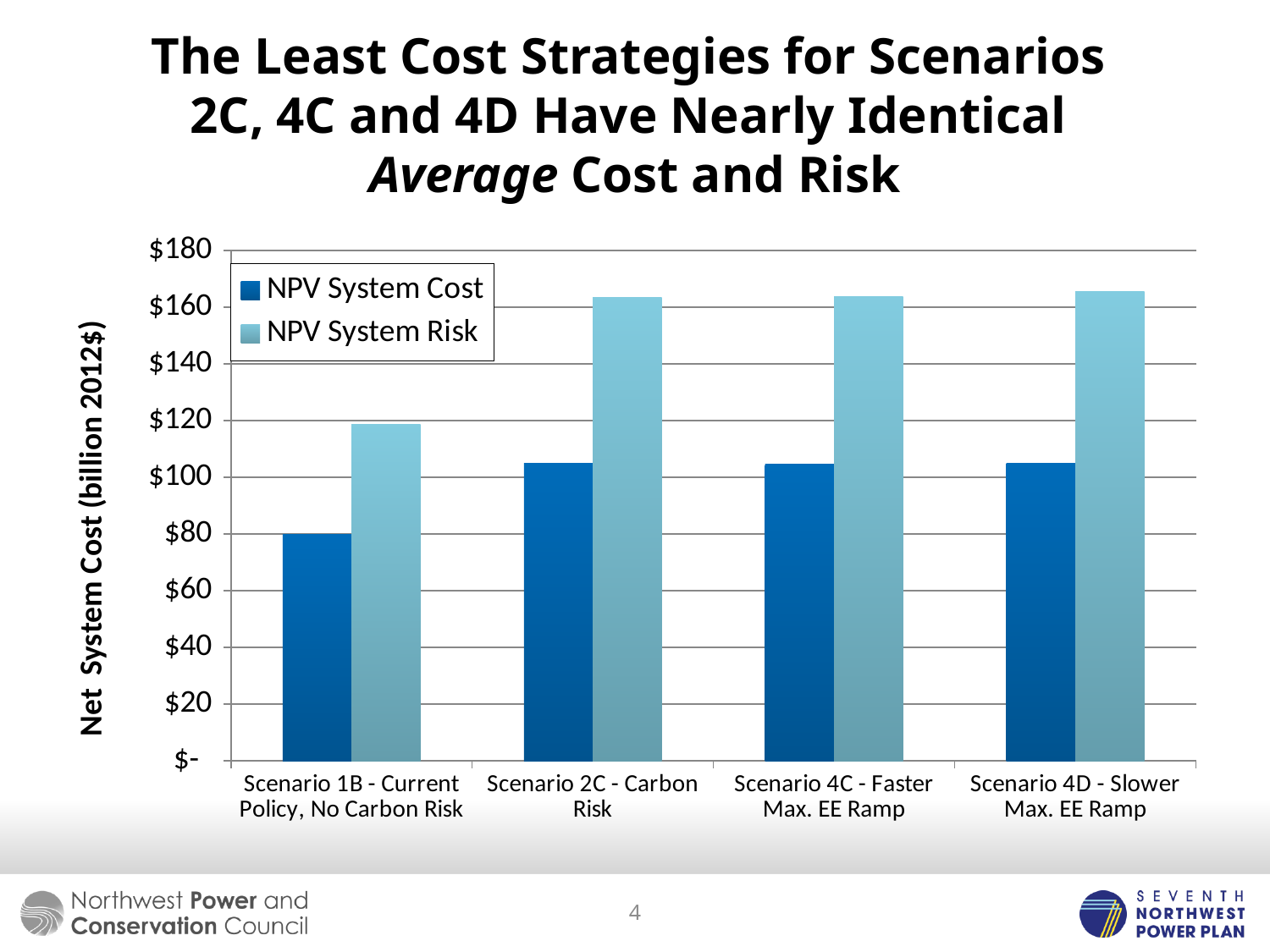
Is the NPV System Risk for Scenario 2C - Carbon Risk greater or less than $140? greater For Scenario 4D - Slower Max. EE Ramp, which is larger: NPV System Cost or NPV System Risk? NPV System Risk Which scenario has the lowest NPV System Risk? Scenario 1B - Current Policy, No Carbon Risk Which scenario has the lowest NPV System Cost? Scenario 1B - Current Policy, No Carbon Risk Which is larger: the NPV System Cost for Scenario 1B - Current Policy, No Carbon Risk or the NPV System Cost for Scenario 2C - Carbon Risk? Scenario 2C - Carbon Risk What is the label on the y axis of the chart? Net System Cost (billion 2012$) Is the NPV System Cost for Scenario 4C - Faster Max. EE Ramp greater or less than $100? greater Is the NPV System Risk for Scenario 1B - Current Policy, No Carbon Risk greater or less than $140? less How many series does the legend list? 2 What kind of chart is shown on the slide? bar chart How many scenarios are shown on the x axis? 4